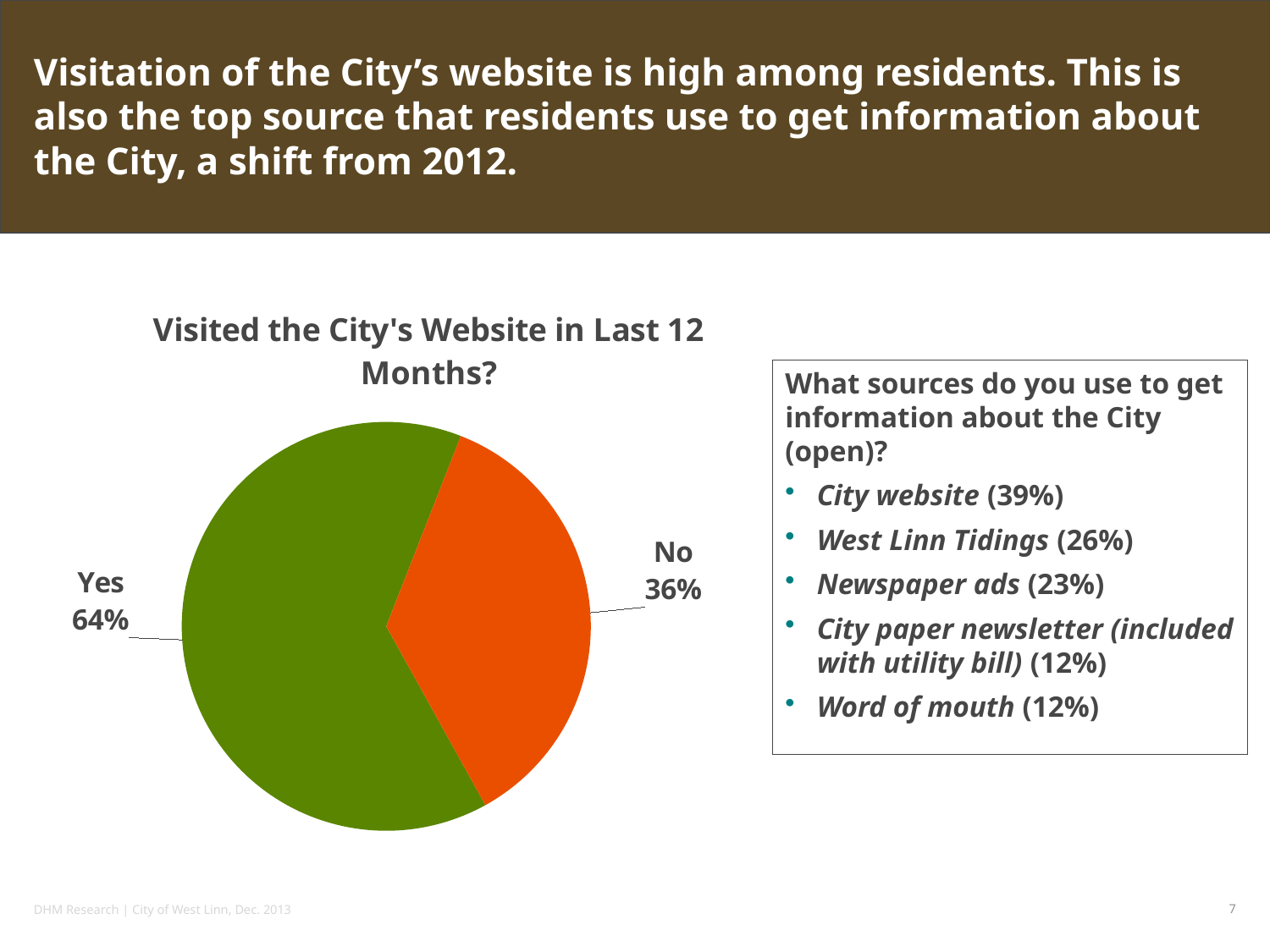
What is the difference in percentage points between the Yes and No slices? 28 What share of the pie does the Yes slice represent? 64% Which is larger, the Yes slice or the No slice? Yes What kind of chart is shown on the slide? pie chart What is the title of the chart? Visited the City's Website in Last 12 Months? What percentage of respondents answered No? 36% What percentage of respondents answered Yes? 64% How many slices does the pie chart have? 2 Which slice of the pie is the smallest? No Which slice of the pie is the largest? Yes What colour is the Yes slice? green